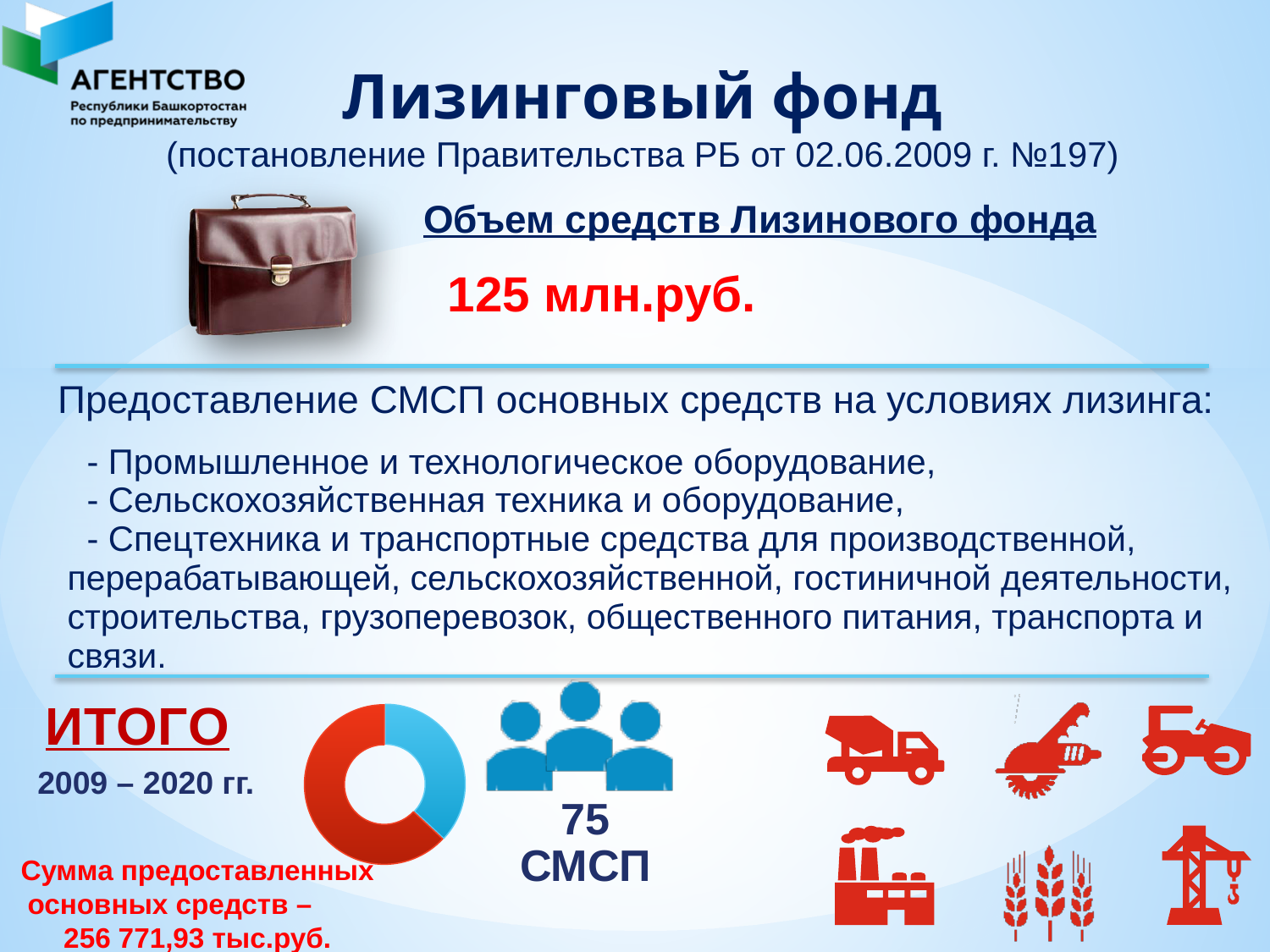
Does the donut chart at the bottom left of the slide show a legend? No How many slices does the donut chart at the bottom left of the slide have? 2 What kind of chart is shown at the bottom left of the slide, next to the word "ИТОГО"? Pie (donut) chart In the donut chart at the bottom left of the slide, which slice is larger, the red one or the blue one? The red one In the donut chart at the bottom left of the slide, which slice is the smallest? The blue slice What two colours are used for the slices of the donut chart at the bottom left of the slide? Red and blue